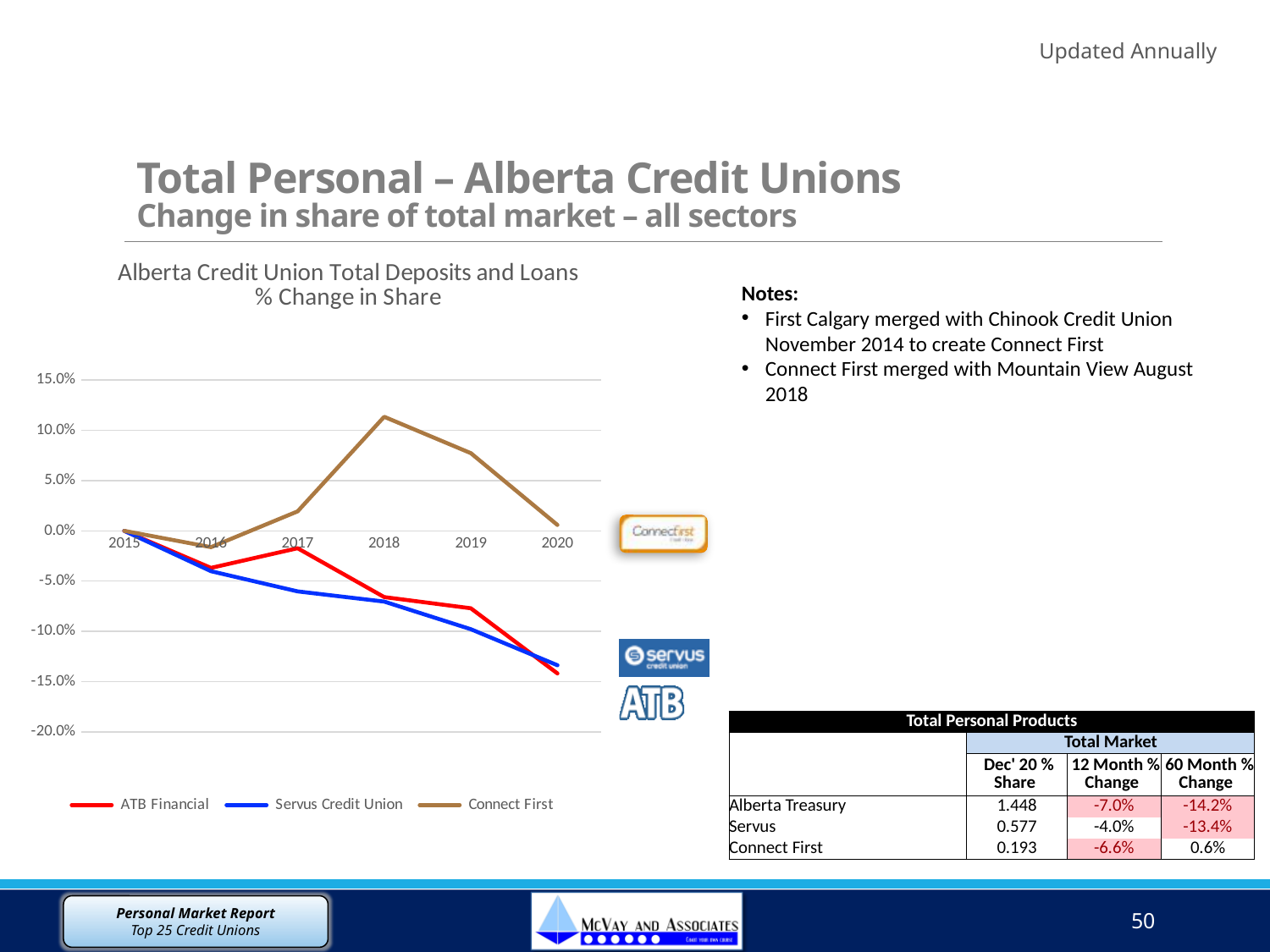
Which series has the lowest value in 2017? Servus Credit Union How many years are plotted along the x axis of the chart? 6 What kind of chart is shown on the slide? line chart Which series has the highest value in 2018? Connect First In 2017, which is larger: the value for ATB Financial or the value for Servus Credit Union? ATB Financial What is the title of the chart? Alberta Credit Union Total Deposits and Loans % Change in Share What is the value for Connect First in 2015? 0.0% Is the value for ATB Financial in 2020 greater or less than -10.0%? less How many series does the chart legend list? 3 Does the Connect First line rise or fall from 2018 to 2020? fall Which series is plotted with the blue line? Servus Credit Union Is the value for Connect First in 2018 greater or less than 10.0%? greater